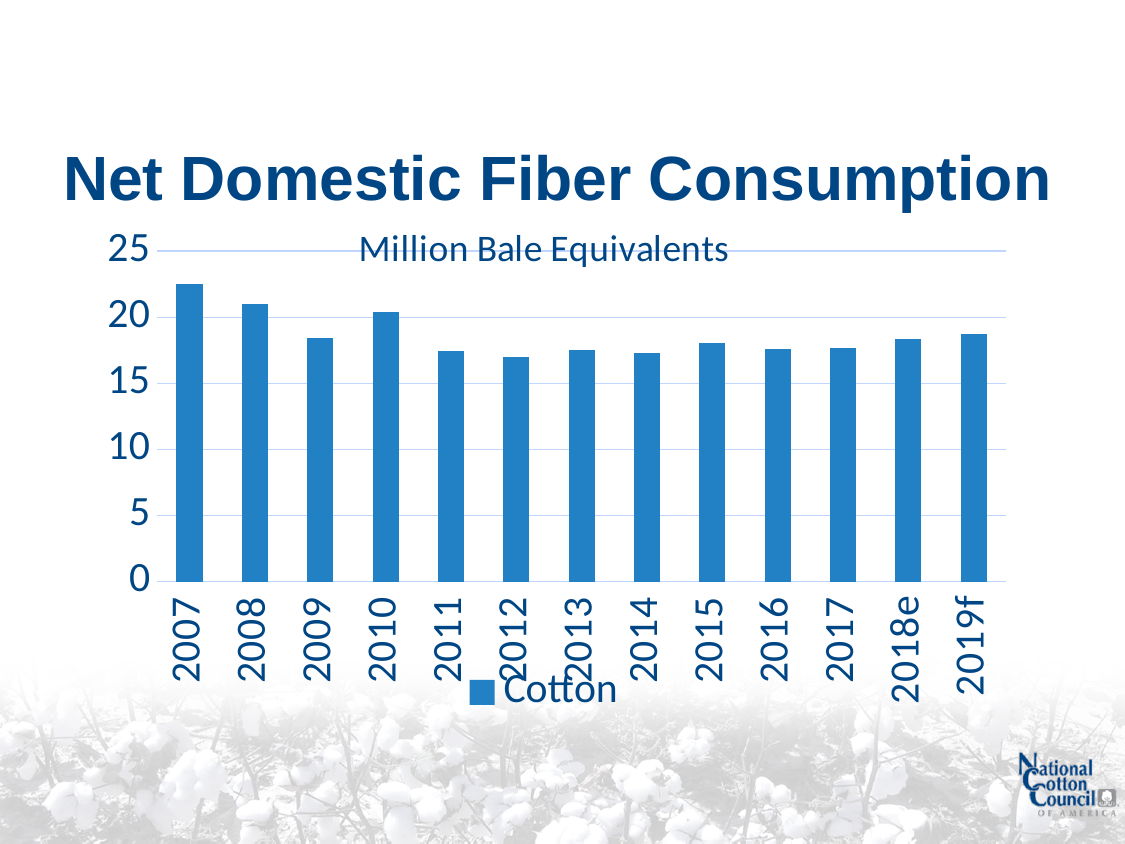
Is the value for 2007 greater or less than 20? greater Is the value for 2009 greater or less than 20? less Which is larger, the value for 2008 or the value for 2009? 2008 How many series does the legend list? 1 Which year has the highest net domestic fiber consumption? 2007 What kind of chart is shown on the slide? bar chart Is the value for 2019f greater or less than 15? greater How many years (categories) are shown on the x axis? 13 What unit is given in the chart's subtitle? Million Bale Equivalents Do the values generally rise or fall from 2007 to 2012? fall